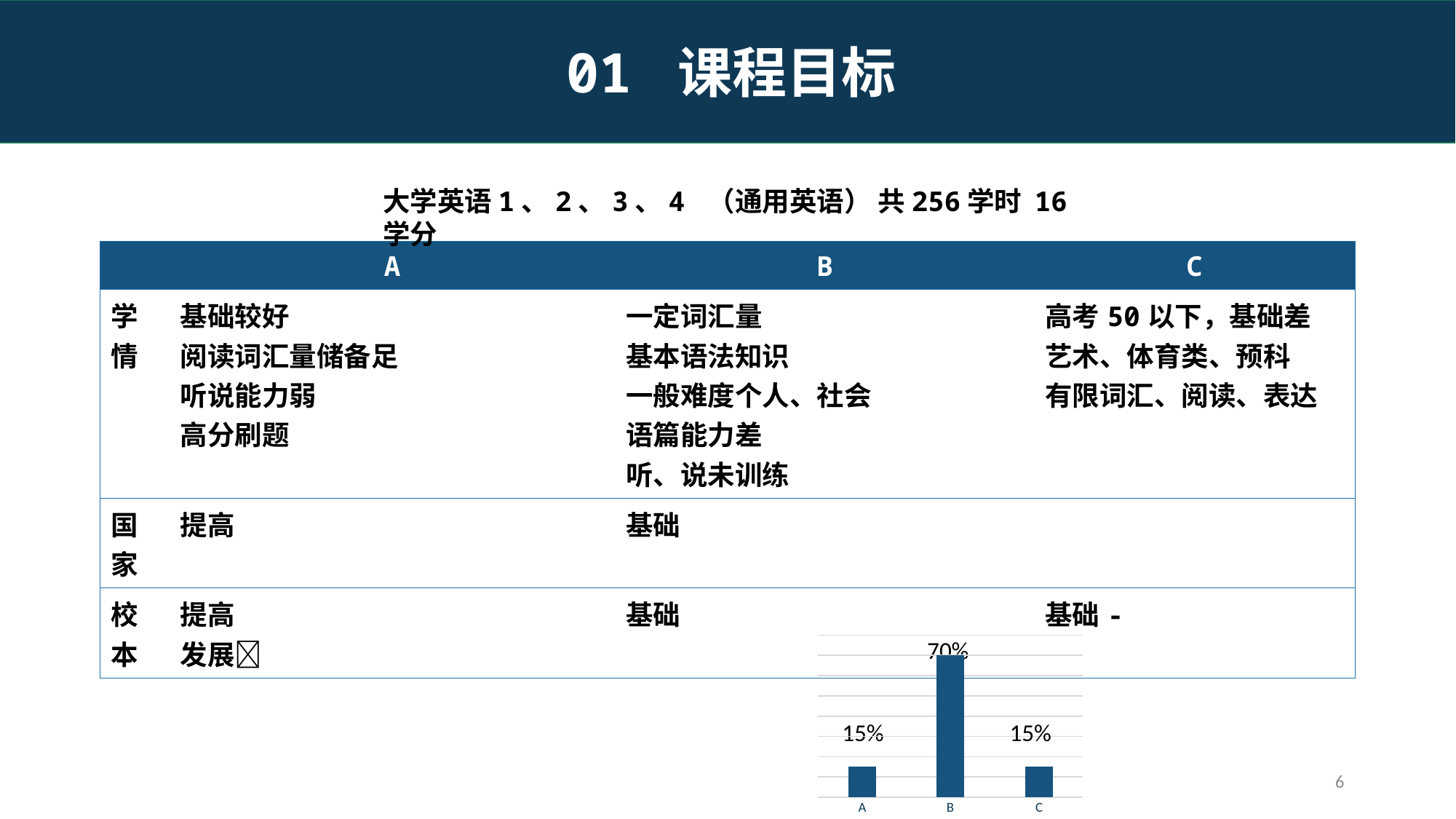
What colour are the bars in the bar chart? dark blue What is the value for category C in the bar chart? 15% Do the values for A and C in the bar chart have the same value? Yes What is the value for category A in the bar chart? 15% What kind of chart is shown at the bottom of the slide? bar chart What are the category labels on the x axis of the bar chart? A, B, C What is the difference between the values for B and C in the bar chart? 55% How many categories are shown on the x axis of the bar chart? 3 What is the difference between the values for B and A in the bar chart? 55% Which is larger in the bar chart, the value for B or the value for C? B What is the value for category B in the bar chart? 70% Which category has the highest value in the bar chart? B